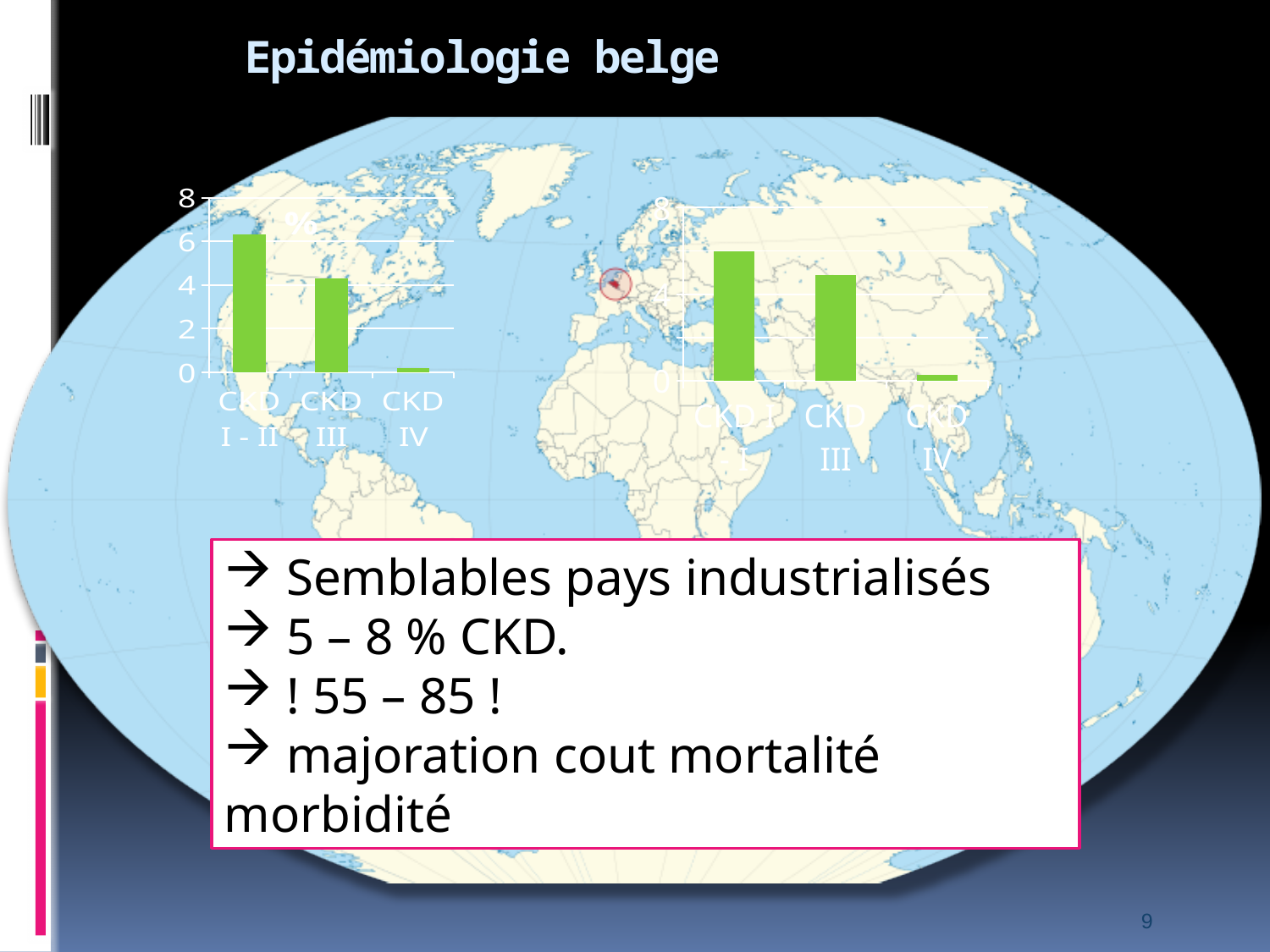
In the left chart, is the value for CKD III greater or less than 6? less What colour are the bars in the two charts? green In the left chart, is the value for CKD IV greater or less than 2? less In the left chart, do the bar values rise or fall from left to right along the x axis? fall In the right chart, which category has the highest bar? CKD I In the right chart, which is larger, the value for CKD III or the value for CKD IV? CKD III In the left chart, which category has the highest bar? CKD I - II In the left chart, which category has the lowest bar? CKD IV How many categories does the left chart show? 3 What kind of chart is the left chart on the slide? bar chart In the left chart, is the value for CKD I - II greater or less than 4? greater